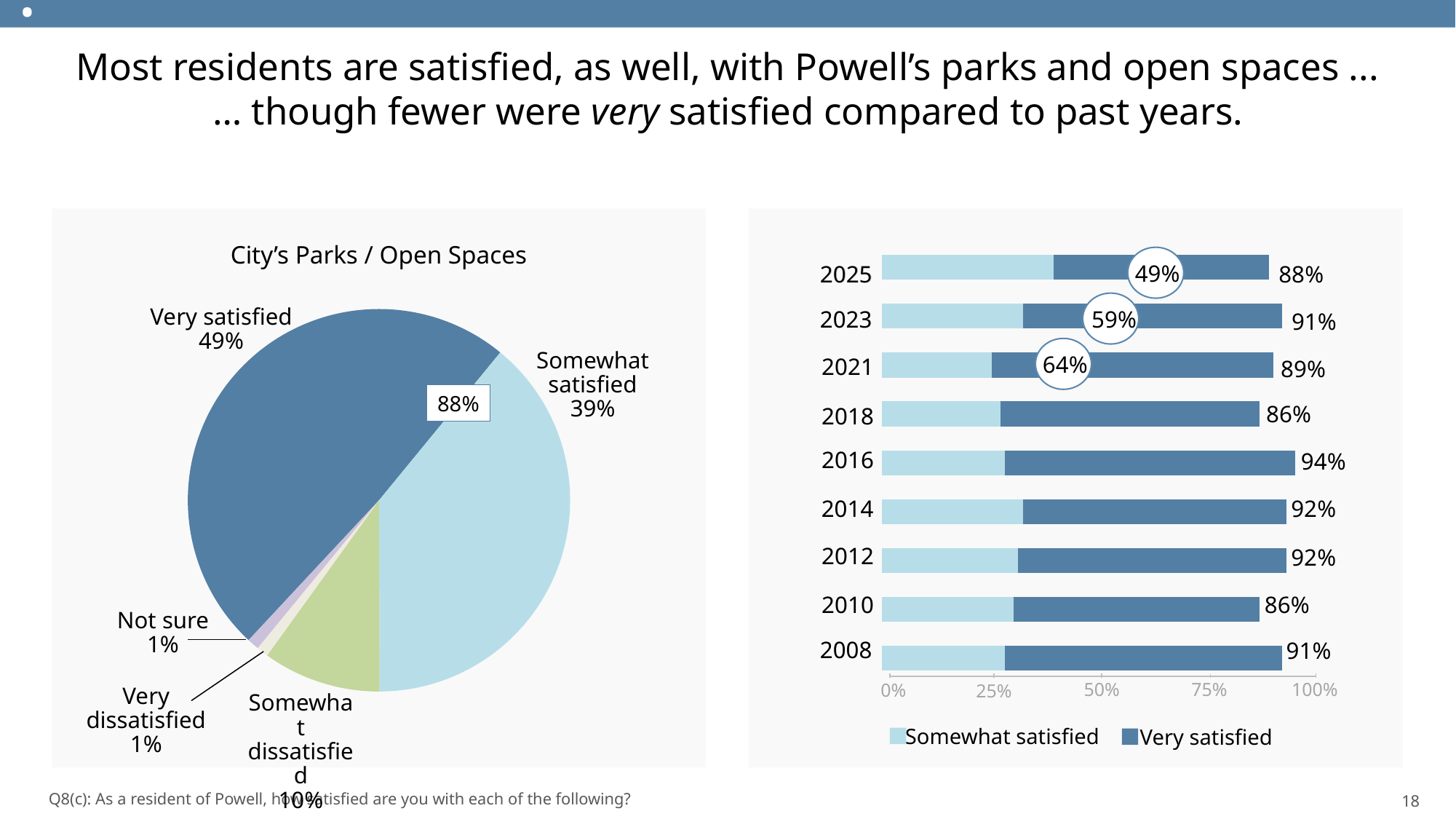
In the bar chart on the right, what is the difference between the total satisfied percentage for 2023 and for 2025? 3 percentage points In the bar chart on the right, what is the total satisfied percentage shown for 2016? 94% In the pie chart titled City's Parks / Open Spaces, which category has the largest slice? Very satisfied How many series does the legend of the bar chart on the right list? 2 In the bar chart on the right, which year has a higher total satisfied percentage, 2014 or 2018? 2014 In the bar chart on the right, which year has the highest total satisfied percentage? 2016 How many slices does the pie chart titled City's Parks / Open Spaces have? 5 In the bar chart on the right, what is the circled Very satisfied percentage for 2021? 64% How many years are shown in the bar chart on the right? 9 What kind of chart is the chart on the left of the slide? Pie chart In the pie chart titled City's Parks / Open Spaces, what percentage of residents are Somewhat dissatisfied? 10% In the pie chart titled City's Parks / Open Spaces, what percentage of residents are Very satisfied? 49%